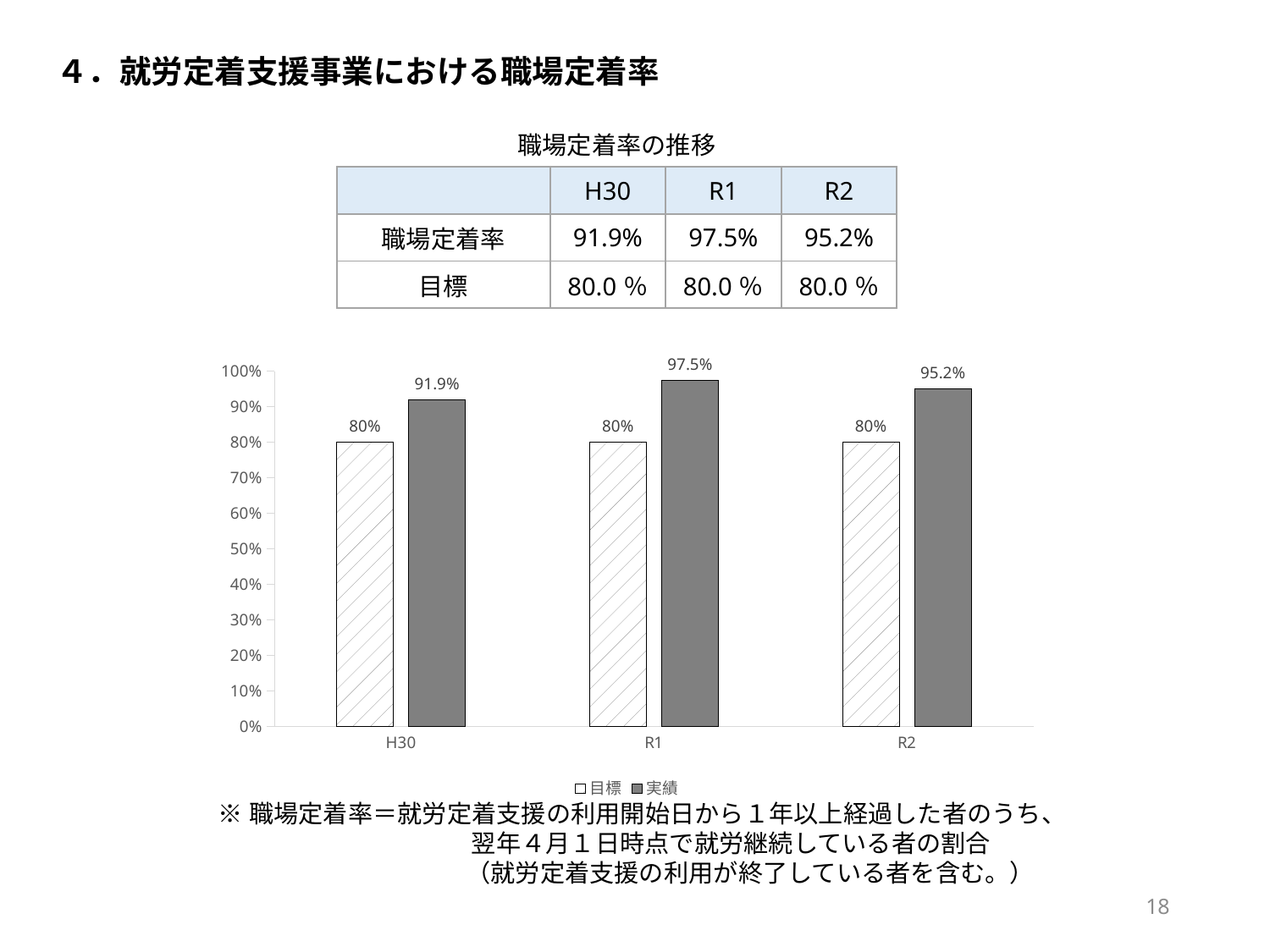
What are the two series listed in the legend? 目標 and 実績 How many years are shown on the x axis? 3 What is the 目標 value for R2? 80% What is the 実績 value for H30? 91.9% What is the difference between the 実績 and 目標 values for R1? 17.5% Which year has the lowest 実績 value? H30 What is the difference between the 実績 values for R1 and R2? 2.3% Which is larger, the 実績 value for H30 or for R2? R2 What kind of chart is shown on the slide? bar chart Which year has the highest 実績 value? R1 What is the 実績 value for R1? 97.5% How many series does the legend list? 2